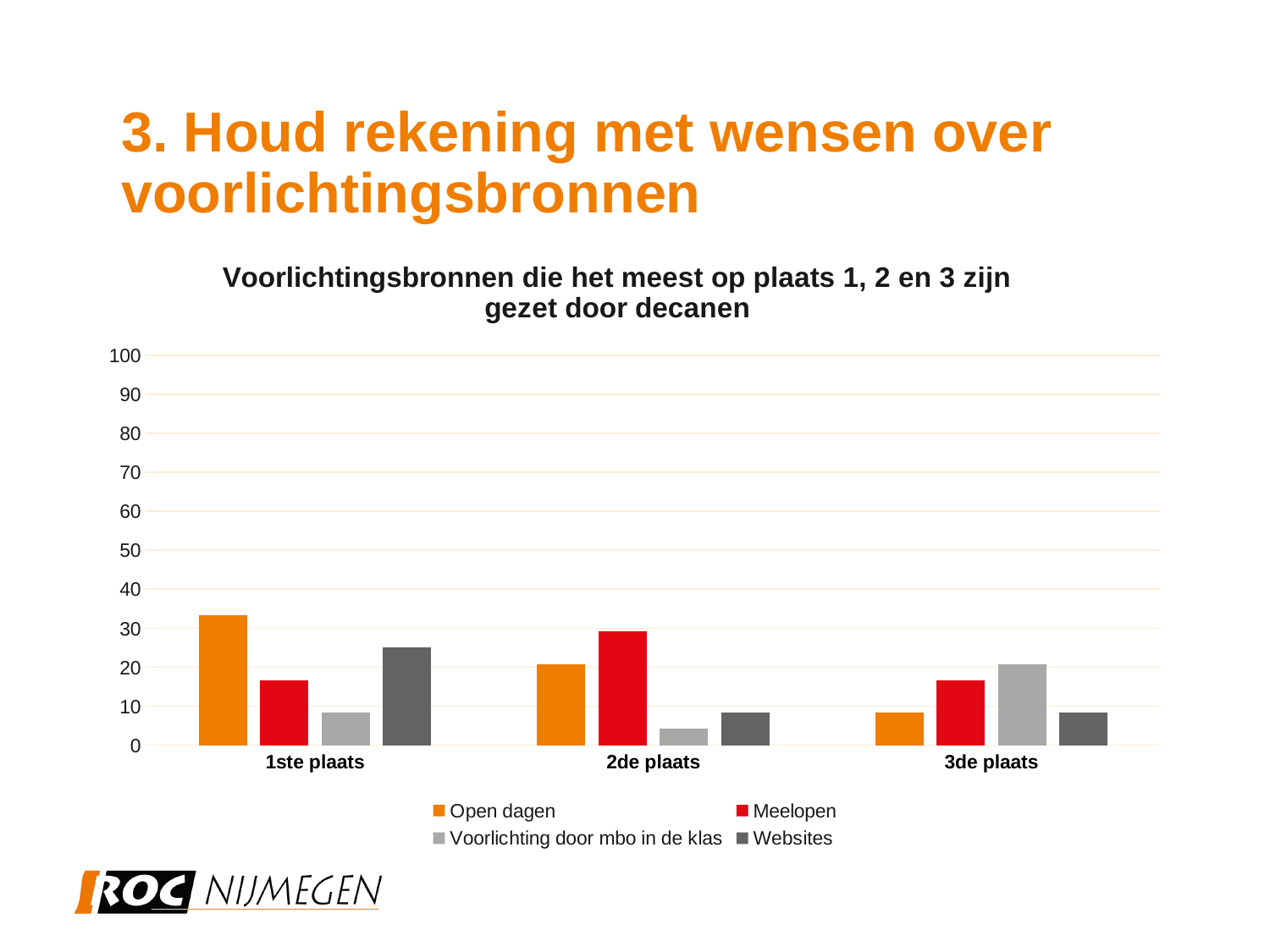
Is the value for Voorlichting door mbo in de klas at 2de plaats greater or less than 10? less Which series has the highest value for 2de plaats? Meelopen Which series has the highest value for 1ste plaats? Open dagen Is the value for Open dagen at 1ste plaats greater or less than 30? greater Which series has the lowest value for 2de plaats? Voorlichting door mbo in de klas What kind of chart is shown on the slide? bar chart Is the value for Websites at 1ste plaats greater or less than 20? greater What colour are the bars for Meelopen? red How many categories are shown on the x axis? 3 How many series does the legend list? 4 Do the values for Open dagen rise or fall from 1ste plaats to 3de plaats? fall Which is larger: the value for Websites at 1ste plaats or the value for Websites at 2de plaats? Websites at 1ste plaats